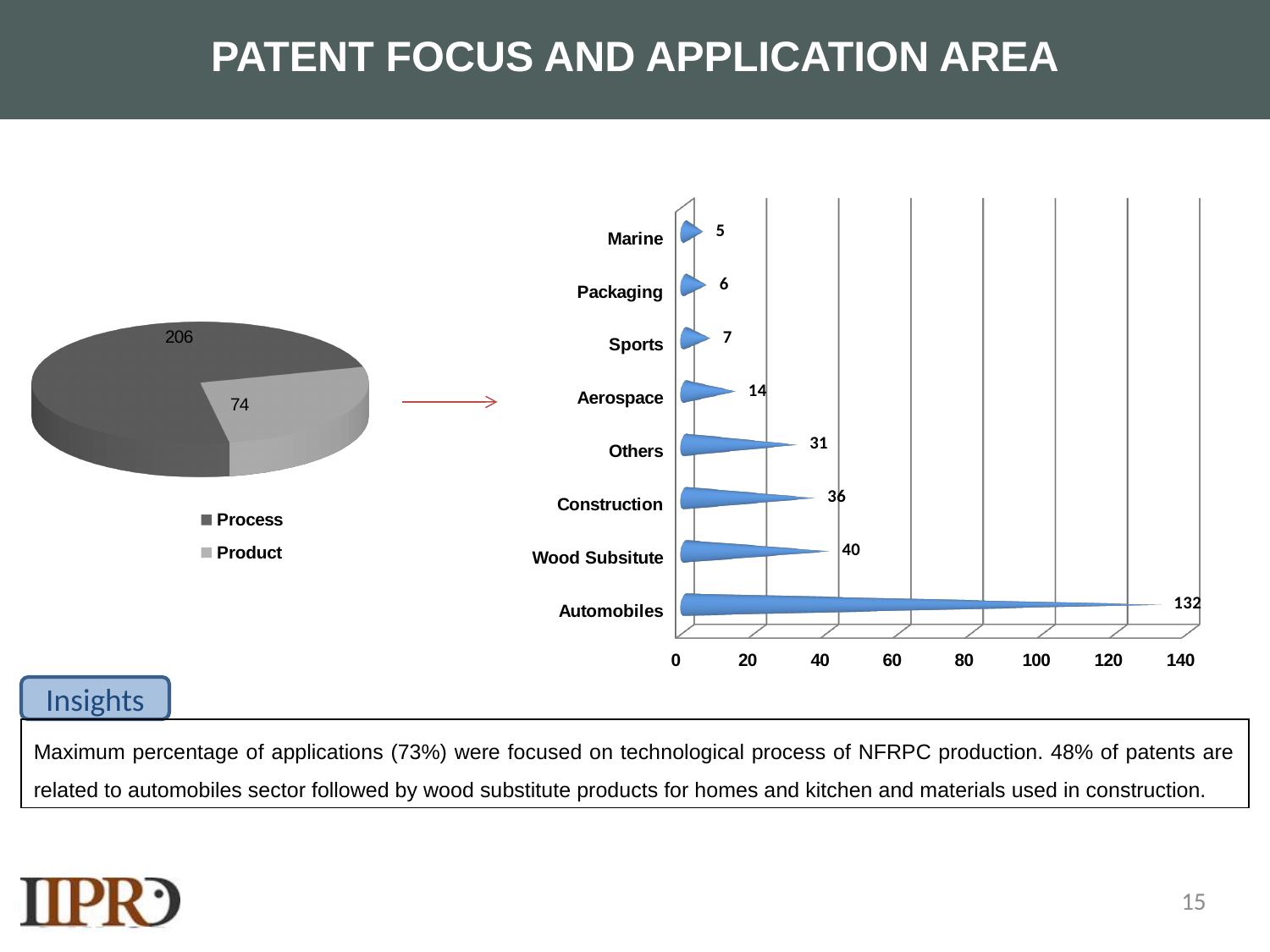
How many entries does the legend of the pie chart on the left list? 2 In the pie chart on the left, what is the value for Process? 206 In the bar chart on the right, which category has the highest value? Automobiles What kind of chart is shown on the right side of the slide? Bar chart In the bar chart on the right, how many categories are shown? 8 In the bar chart on the right, what is the difference between the values for Wood Subsitute and Construction? 4 In the bar chart on the right, which is larger, the value for Others or the value for Aerospace? Others In the bar chart on the right, what is the value for Wood Subsitute? 40 In the bar chart on the right, what is the value for Automobiles? 132 In the pie chart on the left, what is the value for Product? 74 In the bar chart on the right, what is the value for Aerospace? 14 In the bar chart on the right, which category has the lowest value? Marine